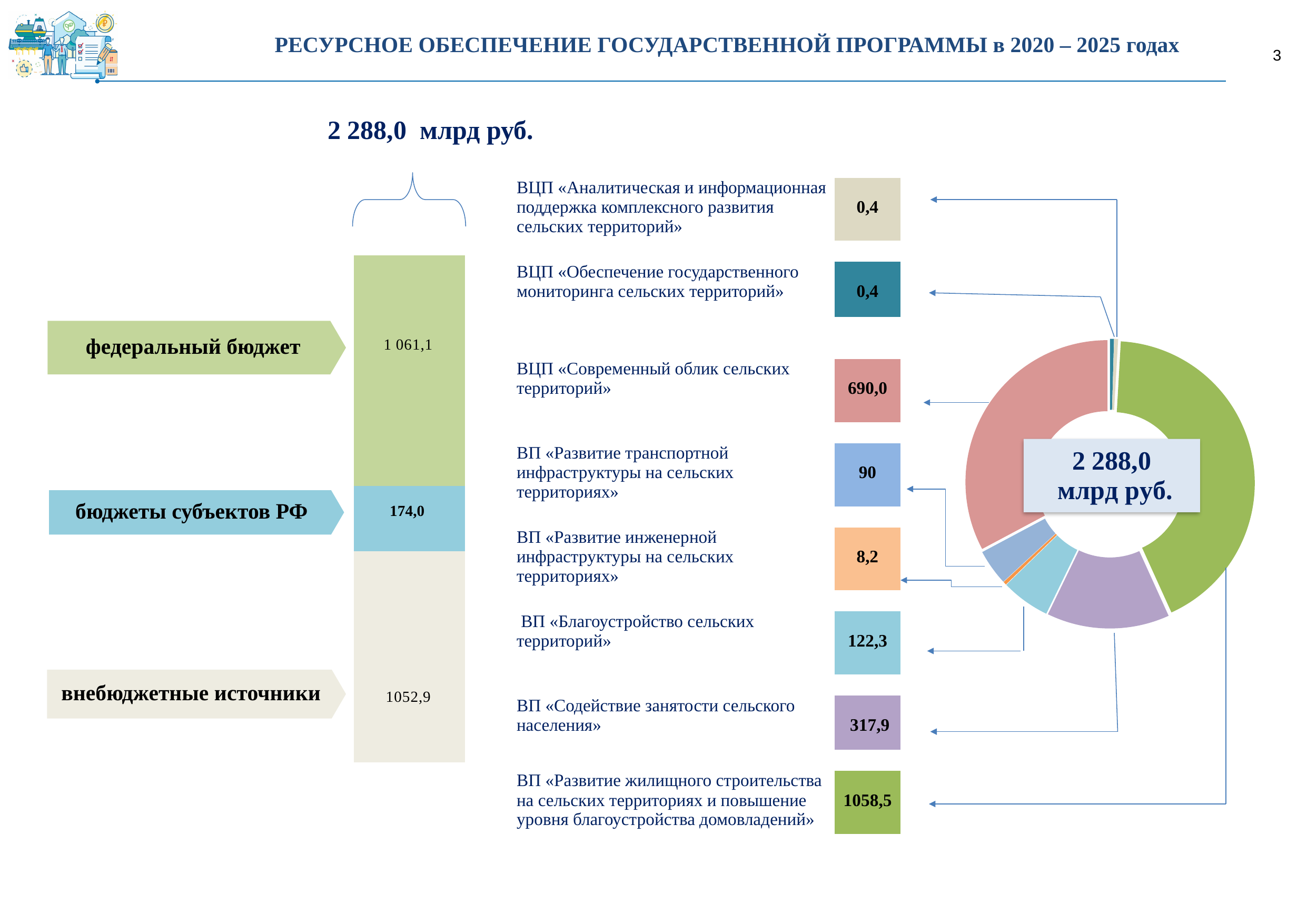
In the stacked bar chart on the left, which source has the smallest value? бюджеты субъектов РФ In the stacked bar chart on the left, what is the value for внебюджетные источники? 1052,9 In the donut chart on the right, which programme has the largest value? ВП «Развитие жилищного строительства на сельских территориях и повышение уровня благоустройства домовладений» In the stacked bar chart on the left, what is the difference between федеральный бюджет and бюджеты субъектов РФ? 887,1 In the stacked bar chart on the left, what is the value for федеральный бюджет? 1 061,1 In the donut chart on the right, what is the value for ВП «Содействие занятости сельского населения»? 317,9 What is the total of the stacked bar on the left, as printed on the slide? 2 288,0 млрд руб. In the donut chart on the right, which is larger: ВП «Благоустройство сельских территорий» or ВП «Развитие транспортной инфраструктуры на сельских территориях»? ВП «Благоустройство сельских территорий» How many segments does the donut chart on the right have? 8 In the stacked bar chart on the left, what is the value for бюджеты субъектов РФ? 174,0 How many segments does the stacked bar chart on the left have? 3 In the donut chart on the right, what is the value for ВЦП «Современный облик сельских территорий»? 690,0